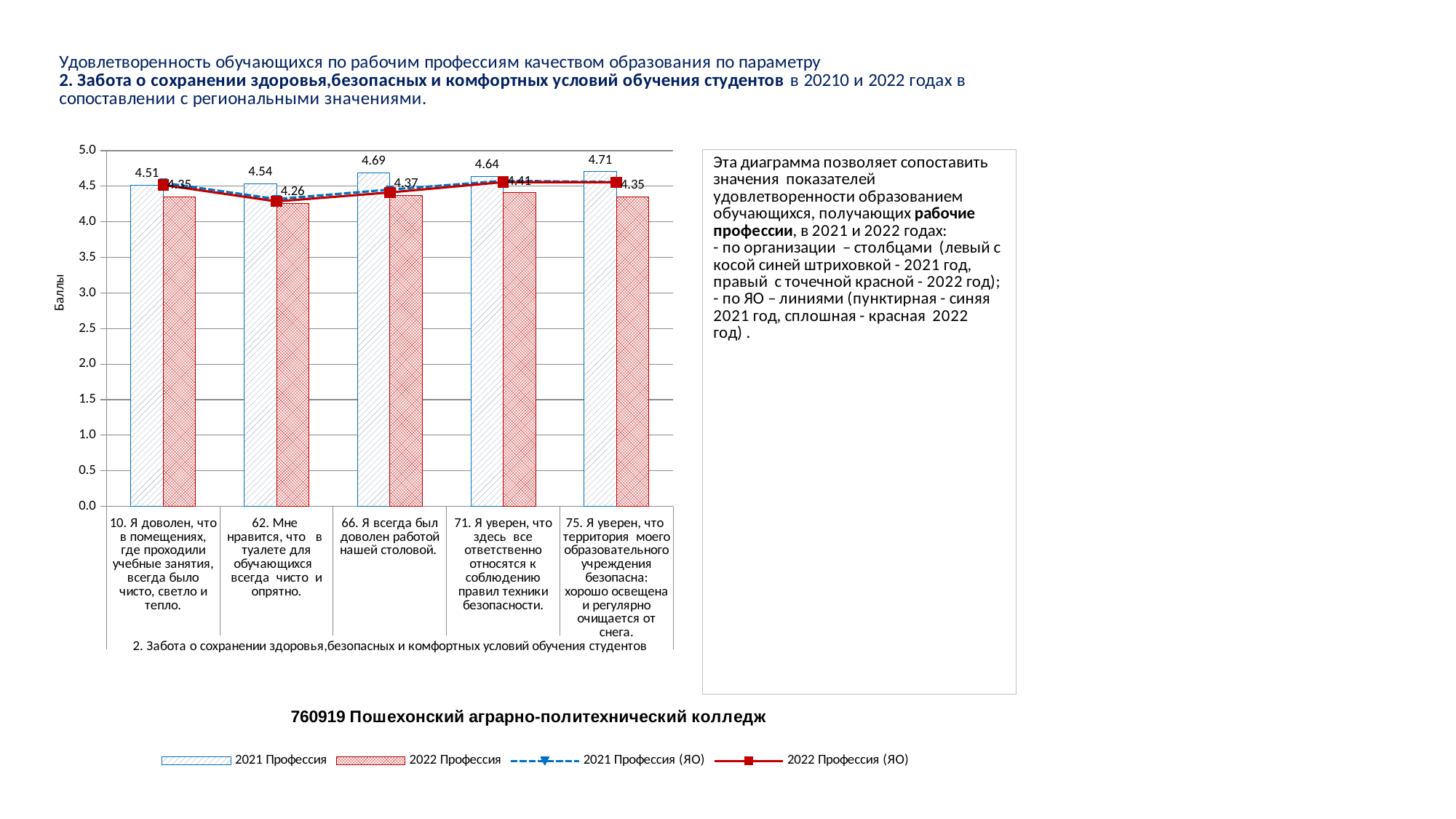
Which category has the highest 2021 Профессия value? 75. Я уверен, что территория моего образовательного учреждения безопасна How many series does the chart legend list? 4 Which is larger for category 75: the 2021 Профессия value or the 2022 Профессия value? 2021 Профессия What is the label of the vertical axis of the chart? Баллы How many categories are shown on the x axis of the chart? 5 Which category has the lowest 2022 Профессия value? 62. Мне нравится, что в туалете для обучающихся всегда чисто и опрятно Is the 2022 Профессия (ЯО) line value for category 62 greater or less than 4.5? less What is the value of the 2022 Профессия bar for category 62 (Мне нравится, что в туалете для обучающихся всегда чисто и опрятно)? 4.26 What is the difference between the 2021 Профессия and 2022 Профессия values for category 10 (Я доволен, что в помещениях, где проходили учебные занятия, всегда было чисто, светло и тепло)? 0.16 What is the value of the 2022 Профессия bar for category 71 (Я уверен, что здесь все ответственно относятся к соблюдению правил техники безопасности)? 4.41 What kind of chart is shown on the slide? Combined bar and line chart What is the value of the 2021 Профессия bar for category 66 (Я всегда был доволен работой нашей столовой)? 4.69